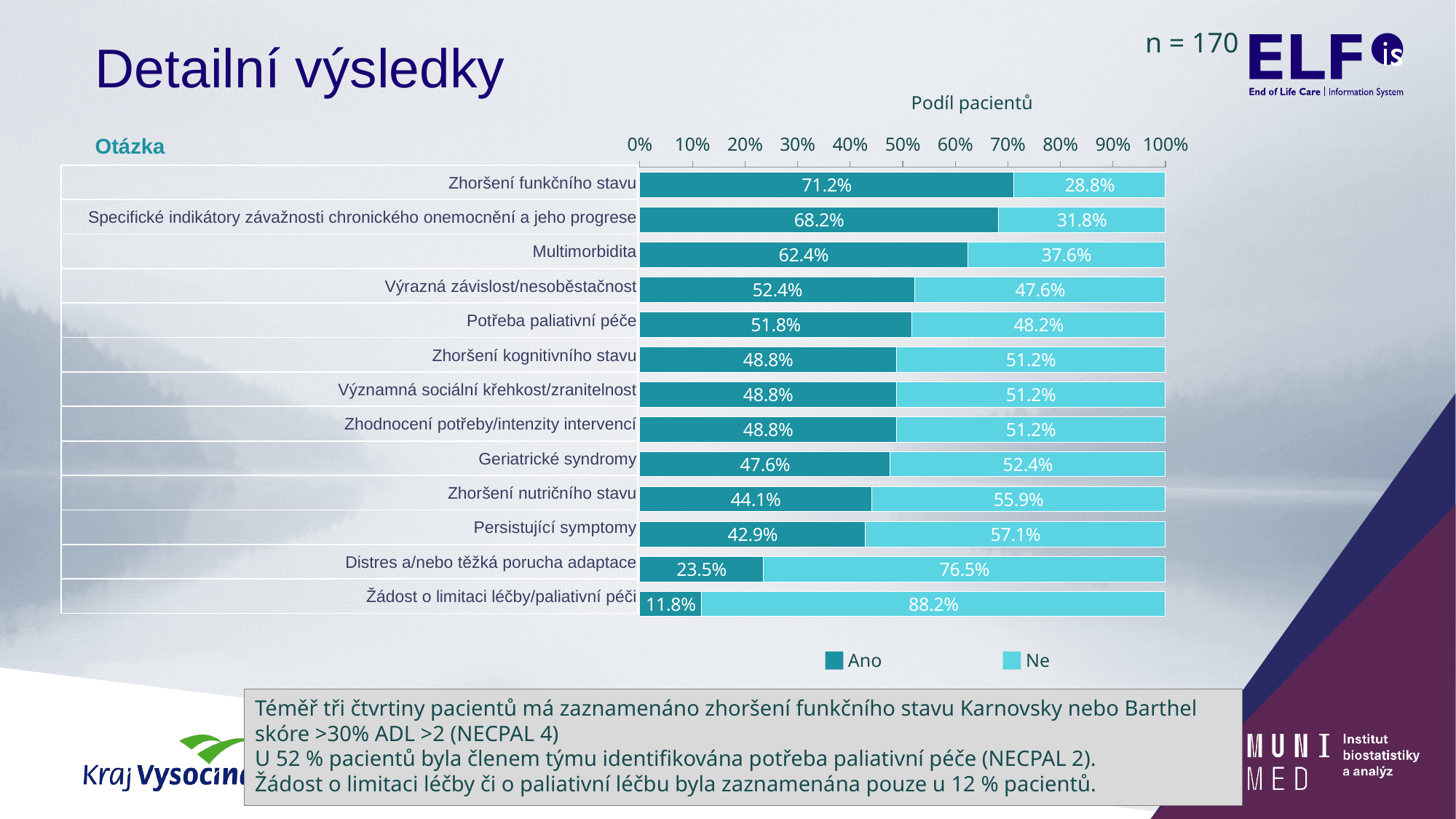
What is the "Ano" value for "Zhoršení funkčního stavu"? 71.2% Which category has the highest "Ano" value? Zhoršení funkčního stavu What is the difference between the "Ano" values for "Zhoršení funkčního stavu" and "Multimorbidita"? 8.8% What is the total of the stacked bar for "Geriatrické syndromy"? 100% What kind of chart is shown on the slide? Stacked bar chart Which is larger: the "Ano" value for "Persistující symptomy" or for "Zhoršení nutričního stavu"? Zhoršení nutričního stavu How many series does the legend list? 2 Is the "Ano" value for "Distres a/nebo těžká porucha adaptace" greater or less than 30%? less Which category has the lowest "Ano" value? Žádost o limitaci léčby/paliativní péči How many categories (questions) are shown in the chart? 13 What is the "Ano" value for "Potřeba paliativní péče"? 51.8% What is the "Ne" value for "Multimorbidita"? 37.6%